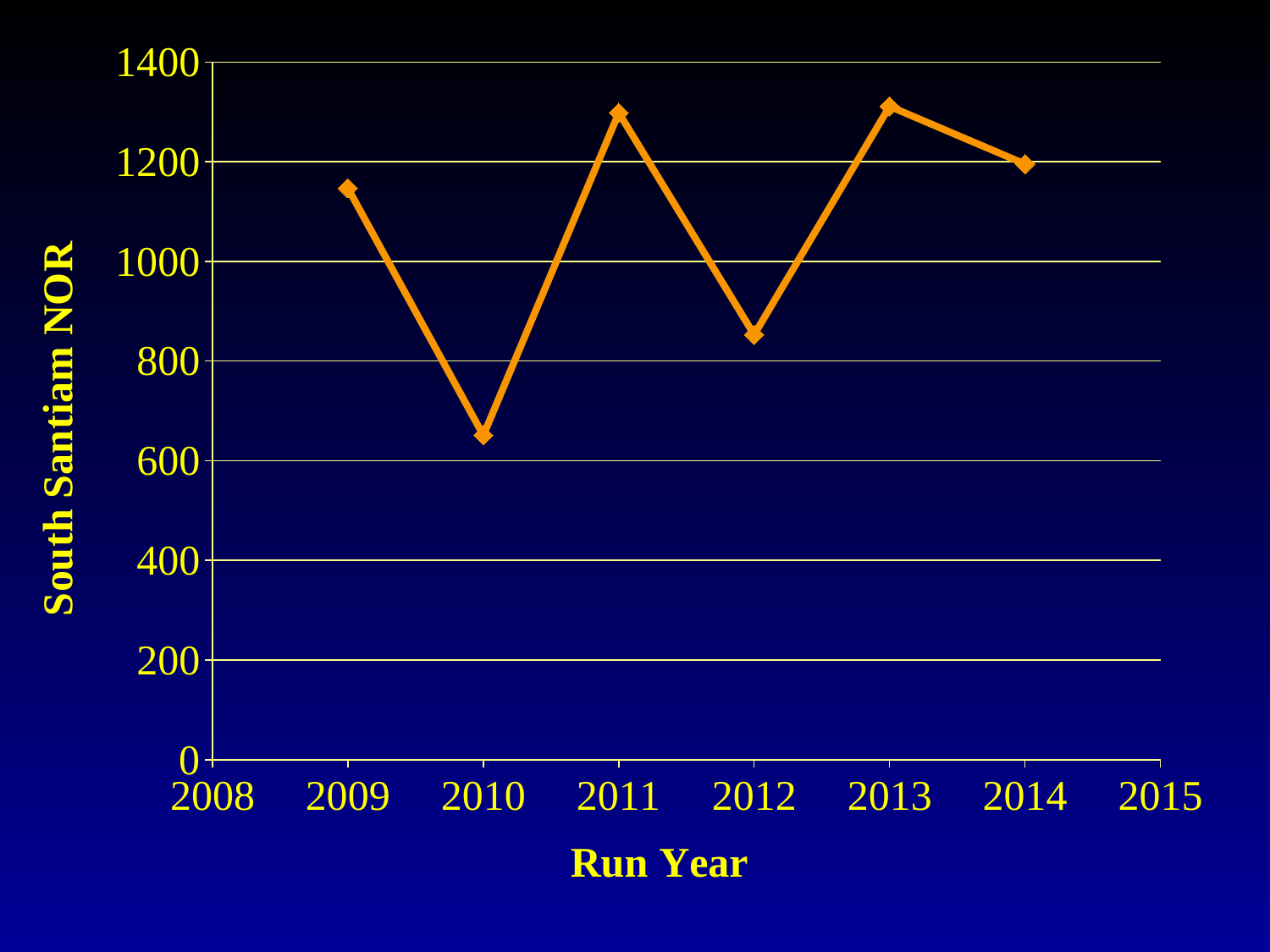
Which run year has the larger value, 2012 or 2014? 2014 Is the value for 2014 greater or less than 1000? greater Is the value for 2011 greater or less than 1200? greater What kind of chart is shown on the slide? line chart Is the value for 2012 greater or less than 1000? less What is the label on the vertical axis? South Santiam NOR Which run year has the larger value, 2009 or 2010? 2009 How many data points are plotted on the line? 6 Which run year has the lowest South Santiam NOR value? 2010 Does the value rise or fall from 2013 to 2014? fall